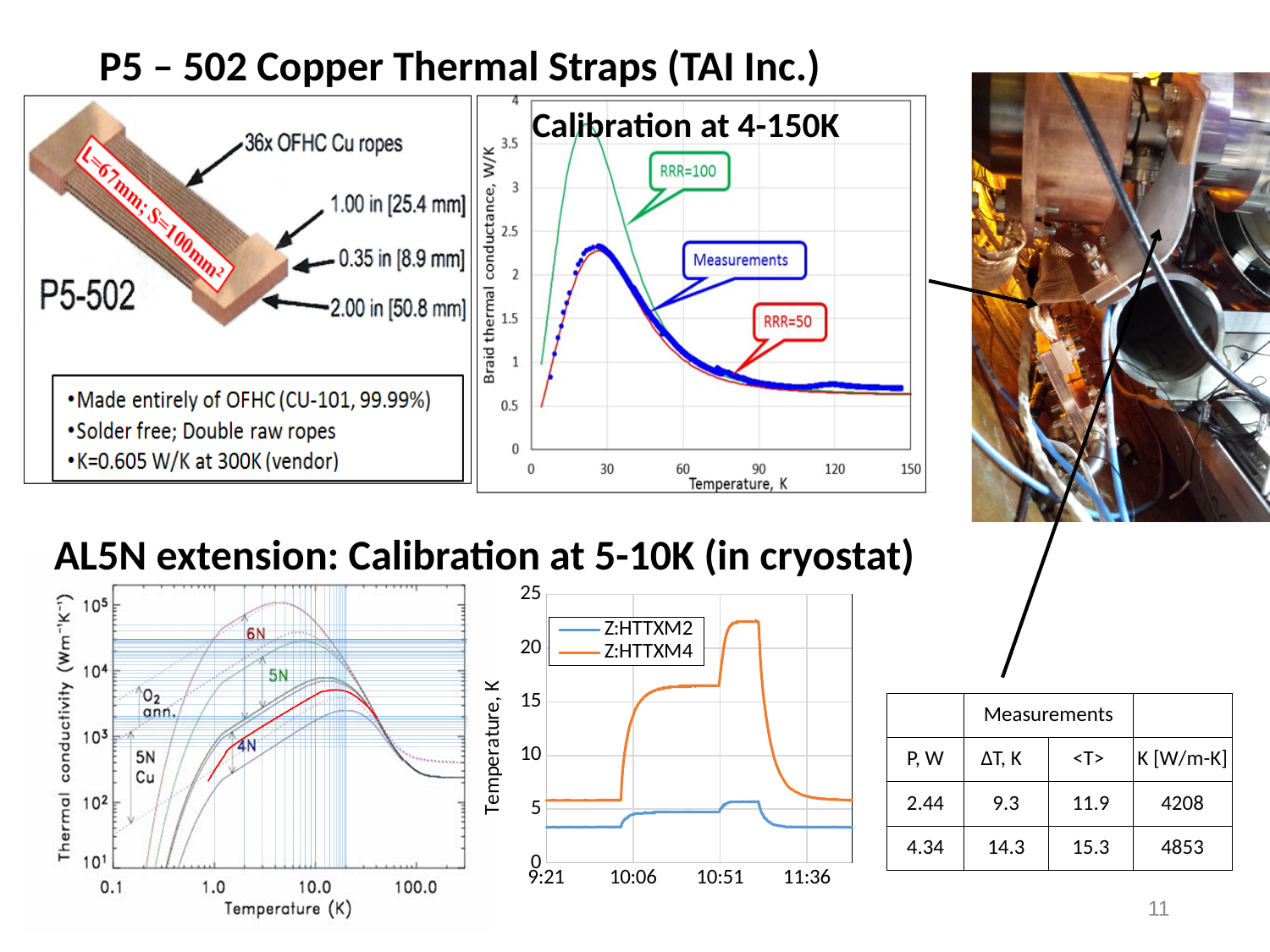
In the 'Calibration at 4-150K' chart, is the peak value of the RRR=100 curve greater or less than 3.5? greater In the temperature-versus-time chart at the bottom middle of the slide, which series reaches higher temperatures, Z:HTTXM2 or Z:HTTXM4? Z:HTTXM4 In the 'Calibration at 4-150K' chart, is the peak value of the Measurements curve greater or less than 2.5? less What kind of chart is the 'Calibration at 4-150K' chart? line chart In the 'Calibration at 4-150K' chart, which curve reaches the highest peak: RRR=100, Measurements, or RRR=50? RRR=100 What is the x-axis label of the thermal conductivity chart at the bottom left of the slide? Temperature (K) In the 'Calibration at 4-150K' chart, do the measured values rise or fall as temperature increases from 30 K to 150 K? fall How many series does the legend list in the temperature-versus-time chart at the bottom middle of the slide? 2 In the 'Calibration at 4-150K' chart, what is the label of the y axis? Braid thermal conductance, W/K In the temperature-versus-time chart at the bottom middle of the slide, is the maximum value of Z:HTTXM2 greater or less than 10? less